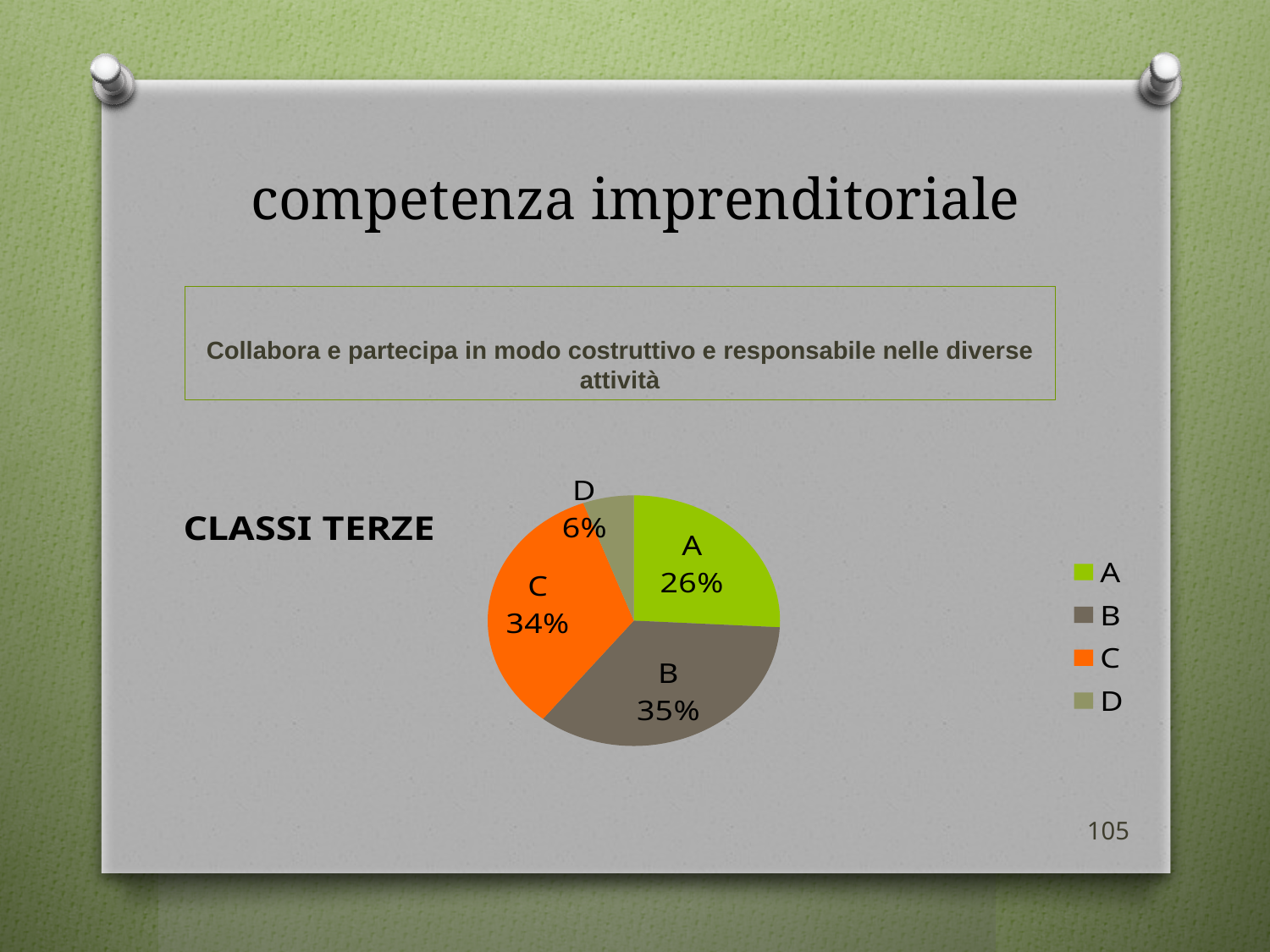
Which is larger, the share of A or the share of C? C What is the share for category C in the pie chart? 34% What is the difference between the shares of B and D? 29% What colour is the slice for category C? orange What type of chart is shown on the slide? pie chart What is the share for category B in the pie chart? 35% How many slices does the pie chart have? 4 Which category has the smallest slice in the pie chart? D How many entries does the legend list? 4 What label appears to the left of the pie chart? CLASSI TERZE What is the share for category A in the pie chart? 26% What is the share for category D in the pie chart? 6%